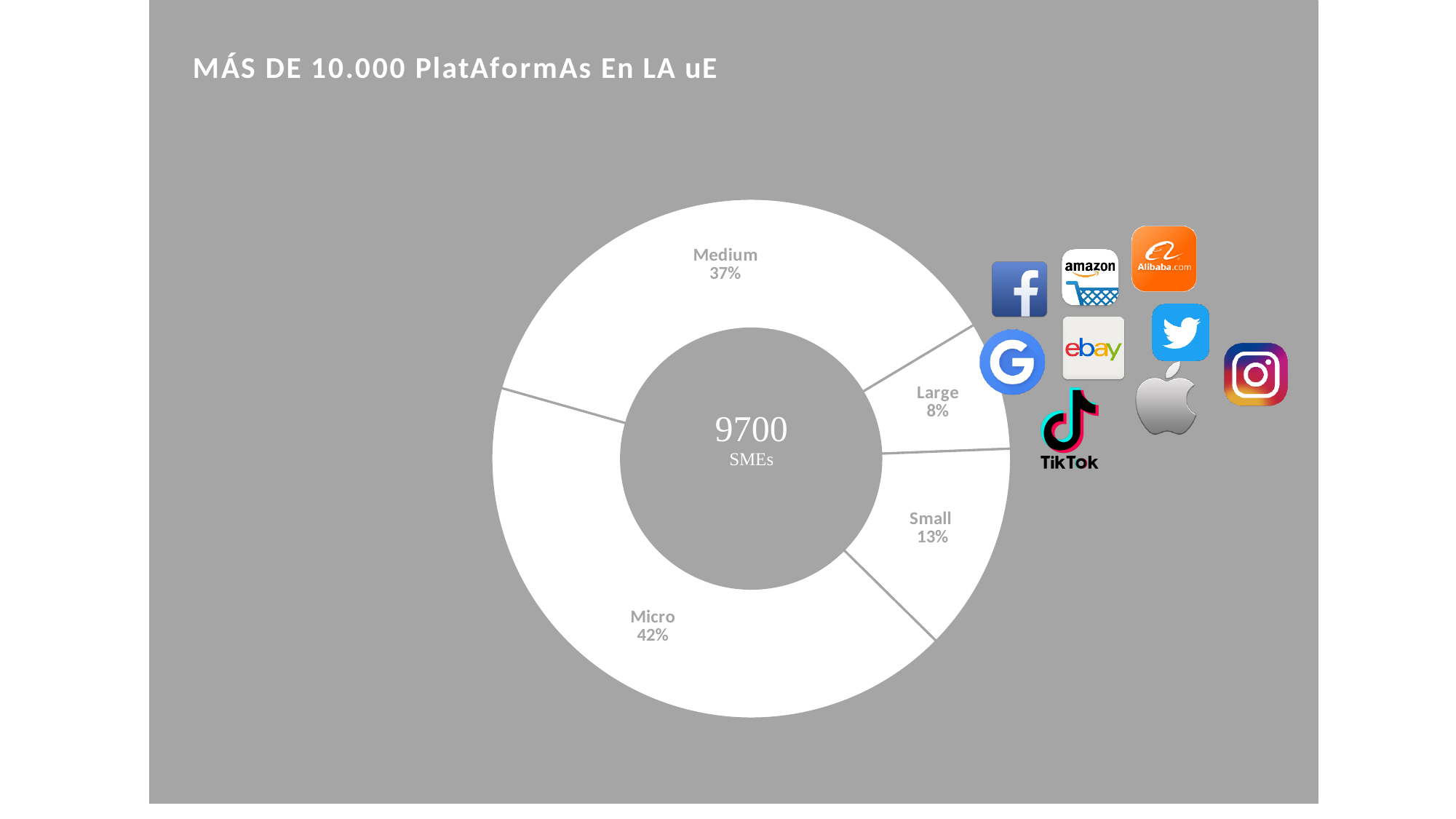
Which category has the smallest share in the doughnut chart? Large How many categories are shown in the doughnut chart? 4 What kind of chart is shown on the slide? Doughnut chart What share of the doughnut chart is labelled Micro? 42% Which share is larger, Small or Large? Small What number is printed in the centre of the doughnut chart? 9700 Which category has the largest share in the doughnut chart? Micro What is the difference in percentage points between the Micro and Medium shares? 5 What share of the doughnut chart is labelled Medium? 37% What share of the doughnut chart is labelled Small? 13% What is the difference in percentage points between the Small and Large shares? 5 What share of the doughnut chart is labelled Large? 8%